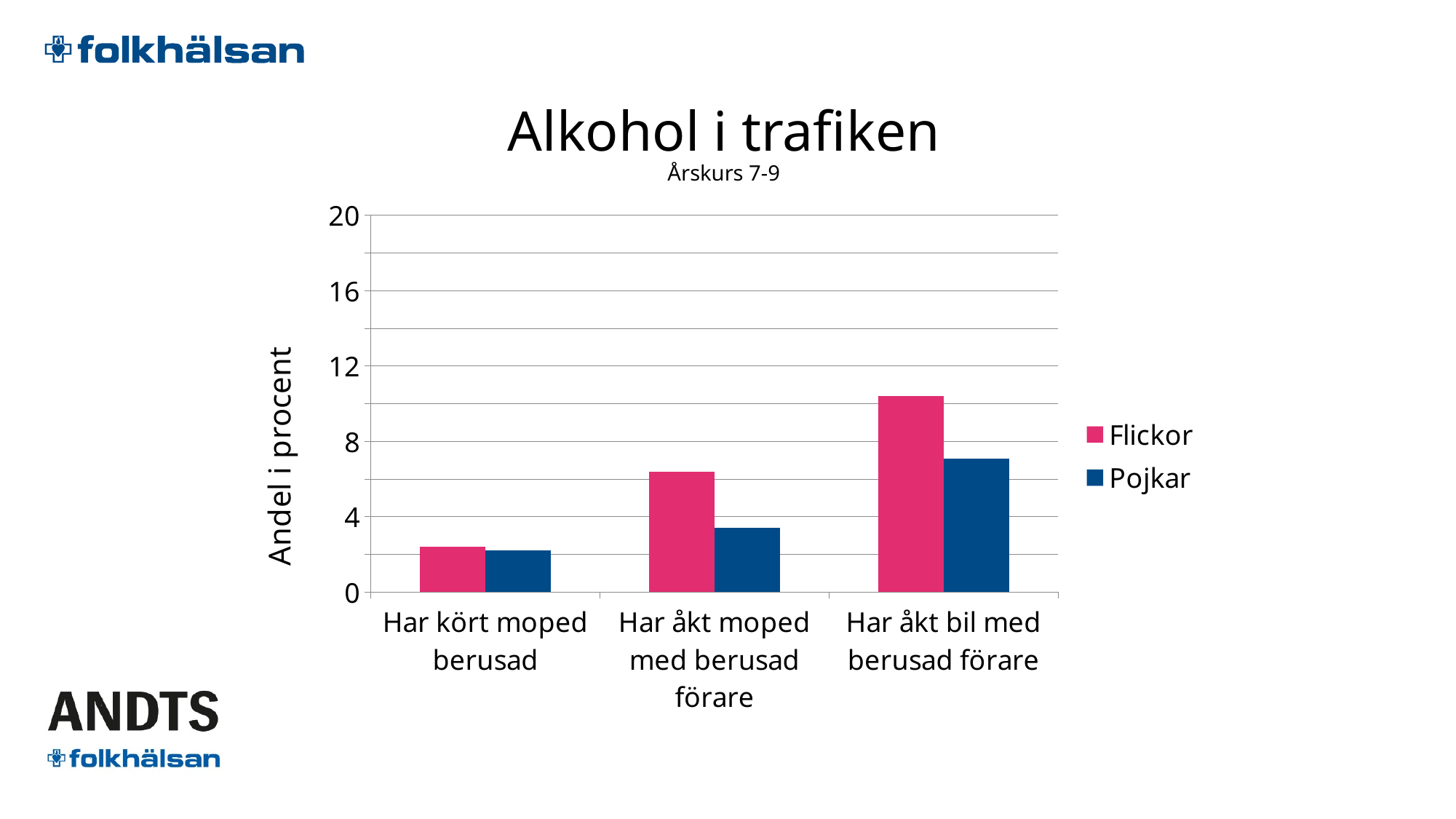
Which category has the highest value for Flickor? Har åkt bil med berusad förare Is the value for Pojkar in 'Har åkt moped med berusad förare' greater or less than 4? less How many categories are shown on the x axis? 3 Which category has the lowest value for Pojkar? Har kört moped berusad What is the label on the y axis? Andel i procent What is the title of the chart? Alkohol i trafiken How many series does the legend list? 2 Is the value for Flickor in 'Har åkt bil med berusad förare' greater or less than 8? greater For 'Har åkt bil med berusad förare', which is larger, Flickor or Pojkar? Flickor For 'Har åkt moped med berusad förare', which is larger, Flickor or Pojkar? Flickor What kind of chart is shown on the slide? bar chart Do the Pojkar values rise or fall from left to right along the x axis? rise